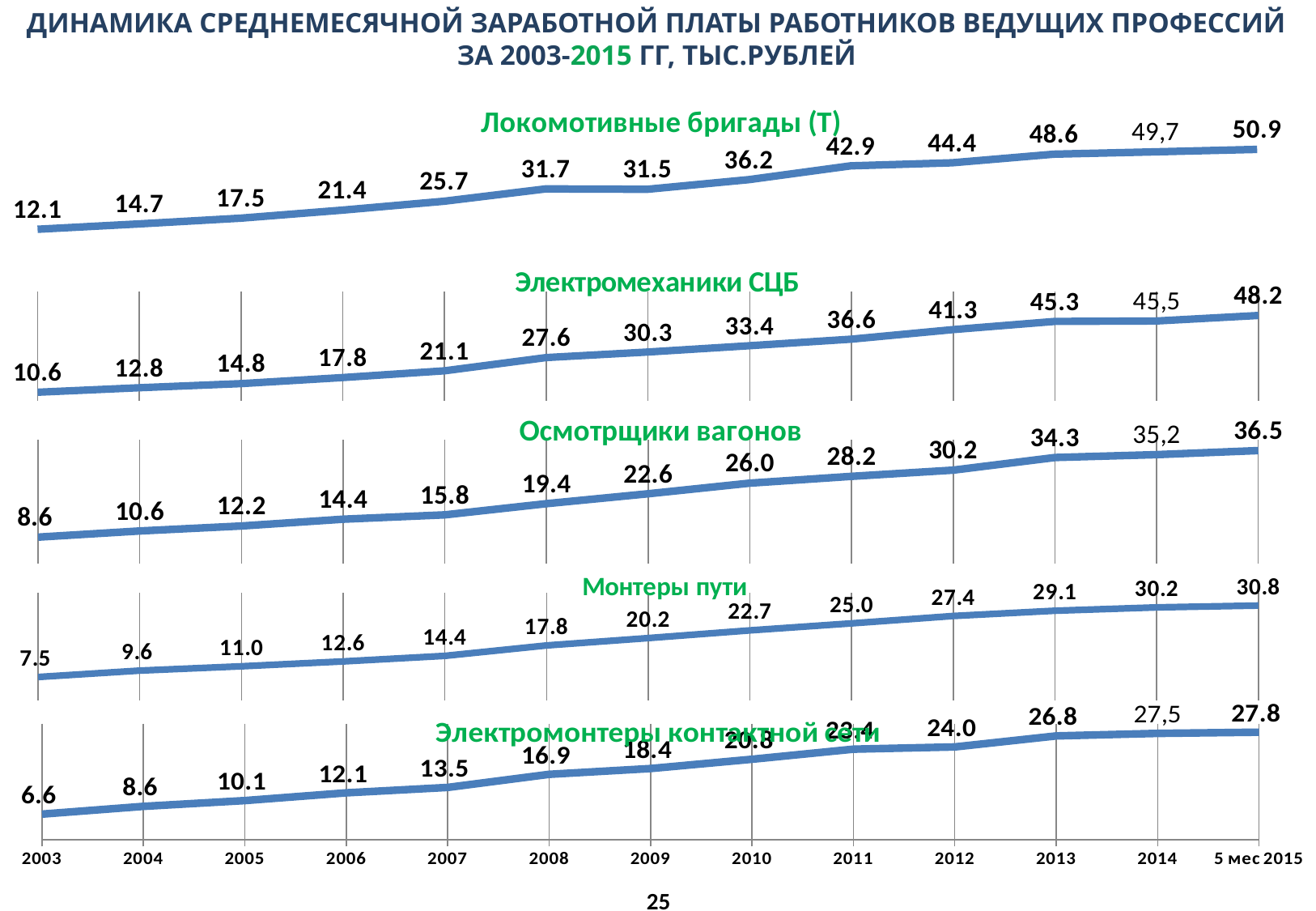
In the 'Осмотрщики вагонов' chart, what is the value for 2003? 8.6 How many data points are plotted in the 'Осмотрщики вагонов' chart? 13 In the 'Электромонтеры контактной сети' chart, what is the value for 2007? 13.5 In the 'Электромеханики СЦБ' chart, what is the difference between the values for 5 мес 2015 and 2003? 37.6 In the 'Локомотивные бригады (Т)' chart, which is larger: the value for 2008 or the value for 2009? 2008 In the 'Электромеханики СЦБ' chart, what is the value for 2012? 41.3 In the 'Локомотивные бригады (Т)' chart, what is the value for 2008? 31.7 What kind of chart is used for 'Монтеры пути'? Line chart In the 'Монтеры пути' chart, what is the value for 5 мес 2015? 30.8 In the 'Локомотивные бригады (Т)' chart, which year has the highest value? 5 мес 2015 In the 'Осмотрщики вагонов' chart, do the values generally rise or fall from 2003 to 5 мес 2015? Rise In the 'Монтеры пути' chart, which year has the lowest value? 2003